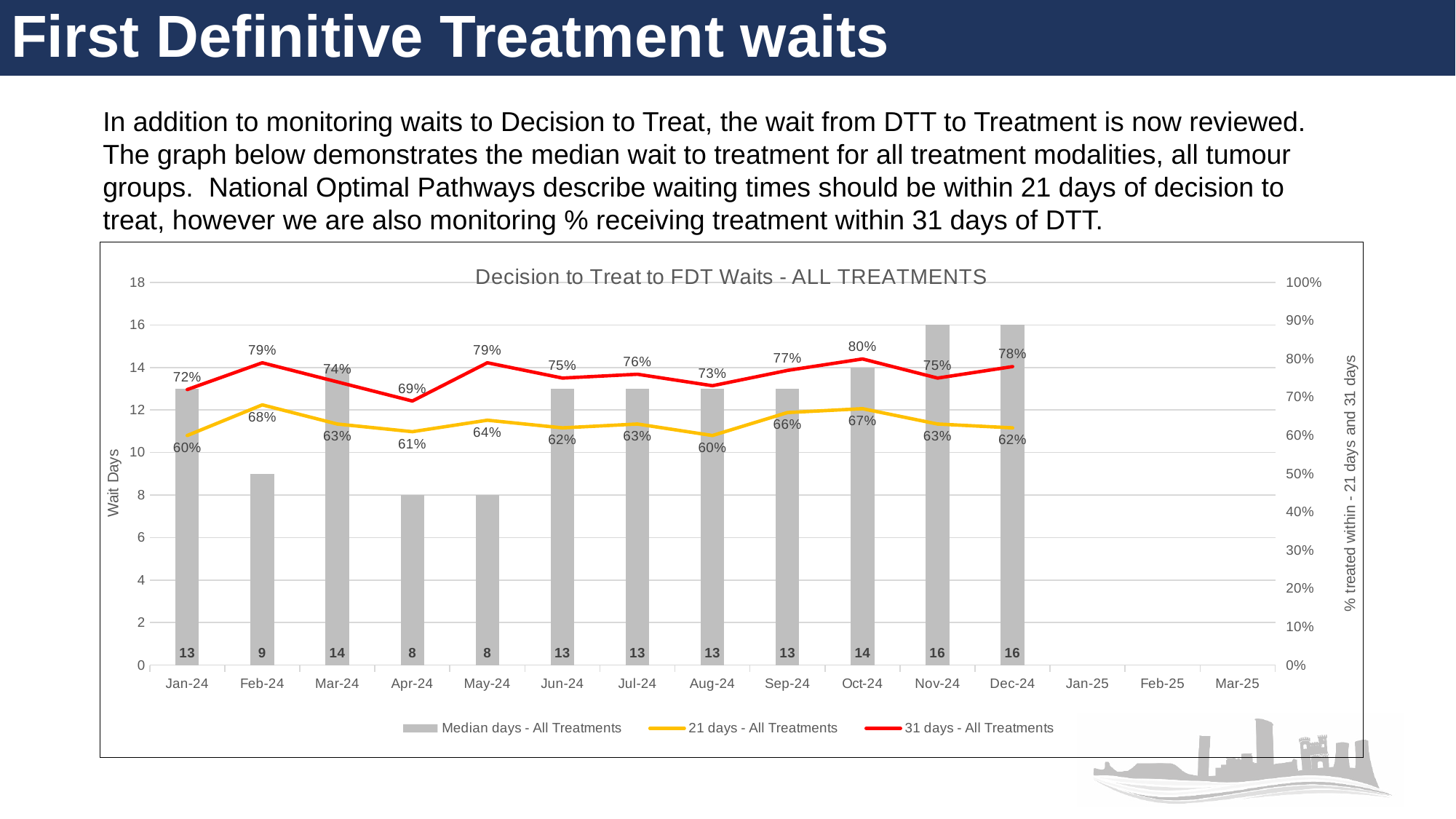
Do the median days rise or fall from Sep-24 to Dec-24? Rise What percentage was treated within 21 days in Feb-24? 68% What is the median days value for Mar-24? 14 How many series does the legend list? 3 How many months have a median days bar plotted? 12 In which month is the '31 days - All Treatments' percentage highest? Oct-24 What kind of chart is shown? Combination bar and line chart What is the difference between the 31-day percentage in Oct-24 and in Apr-24? 11 percentage points Which month has the higher median days, Feb-24 or Apr-24? Feb-24 What percentage was treated within 31 days in Oct-24? 80% In which month is the '21 days - All Treatments' percentage highest? Feb-24 In which month is the '31 days - All Treatments' percentage lowest? Apr-24